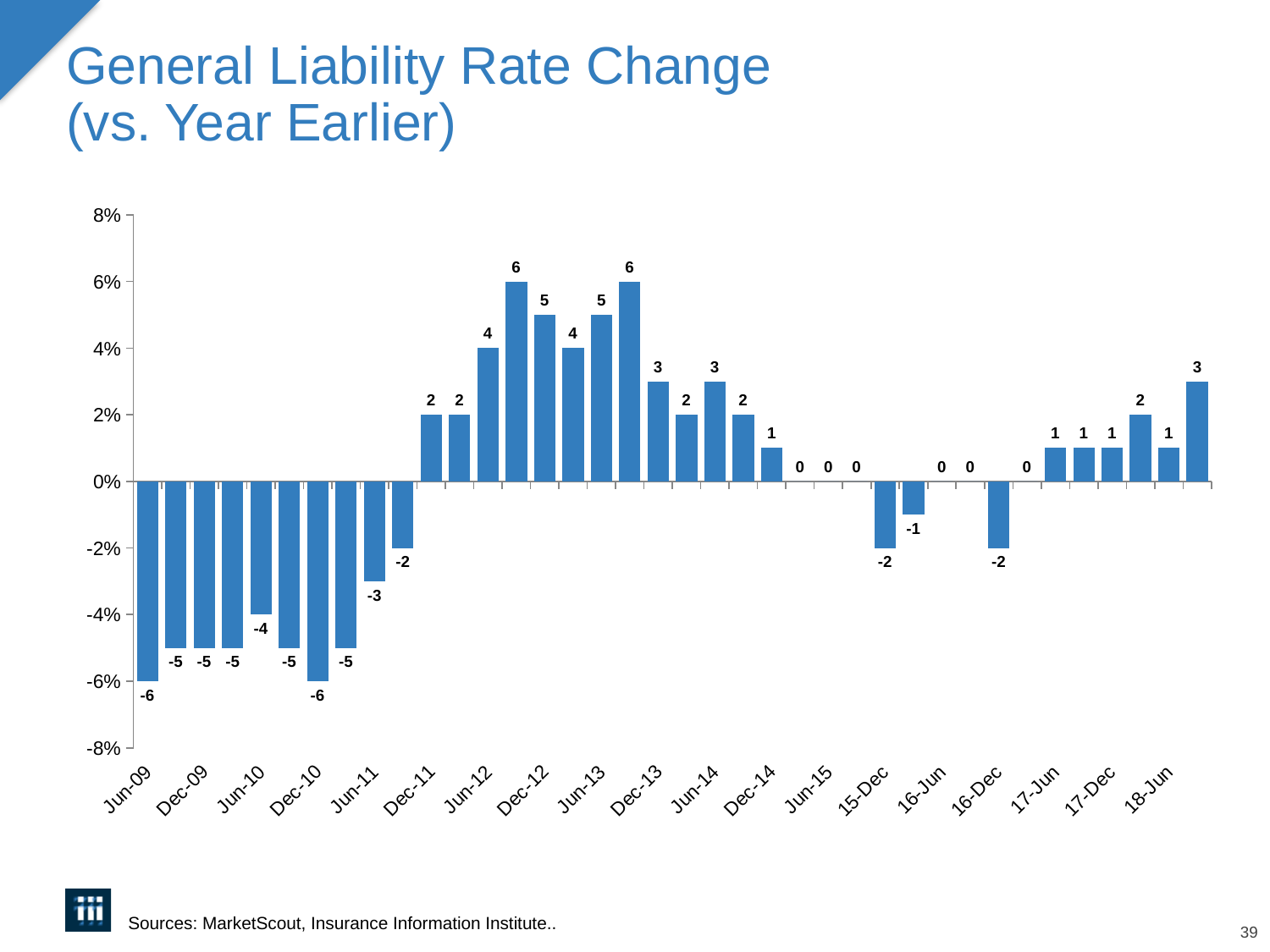
What is the title of the chart? General Liability Rate Change (vs. Year Earlier) Which is larger, the value at Jun-09 or the value at Dec-11? Dec-11 What type of chart is shown on the slide? Bar chart How many bars are plotted in the chart? 38 Do the values rise or fall from Jun-09 to Dec-11? Rise What is the value of the first bar, labeled Jun-09? -6 What is the value of the bar at Jun-15? 0 What is the lowest value shown by any bar in the chart? -6 What is the value of the bar at 17-Jun? 1 What is the value of the bar at Dec-11? 2 What is the difference between the highest bar value (6) and the lowest bar value (-6)? 12 What is the highest value shown by any bar in the chart? 6